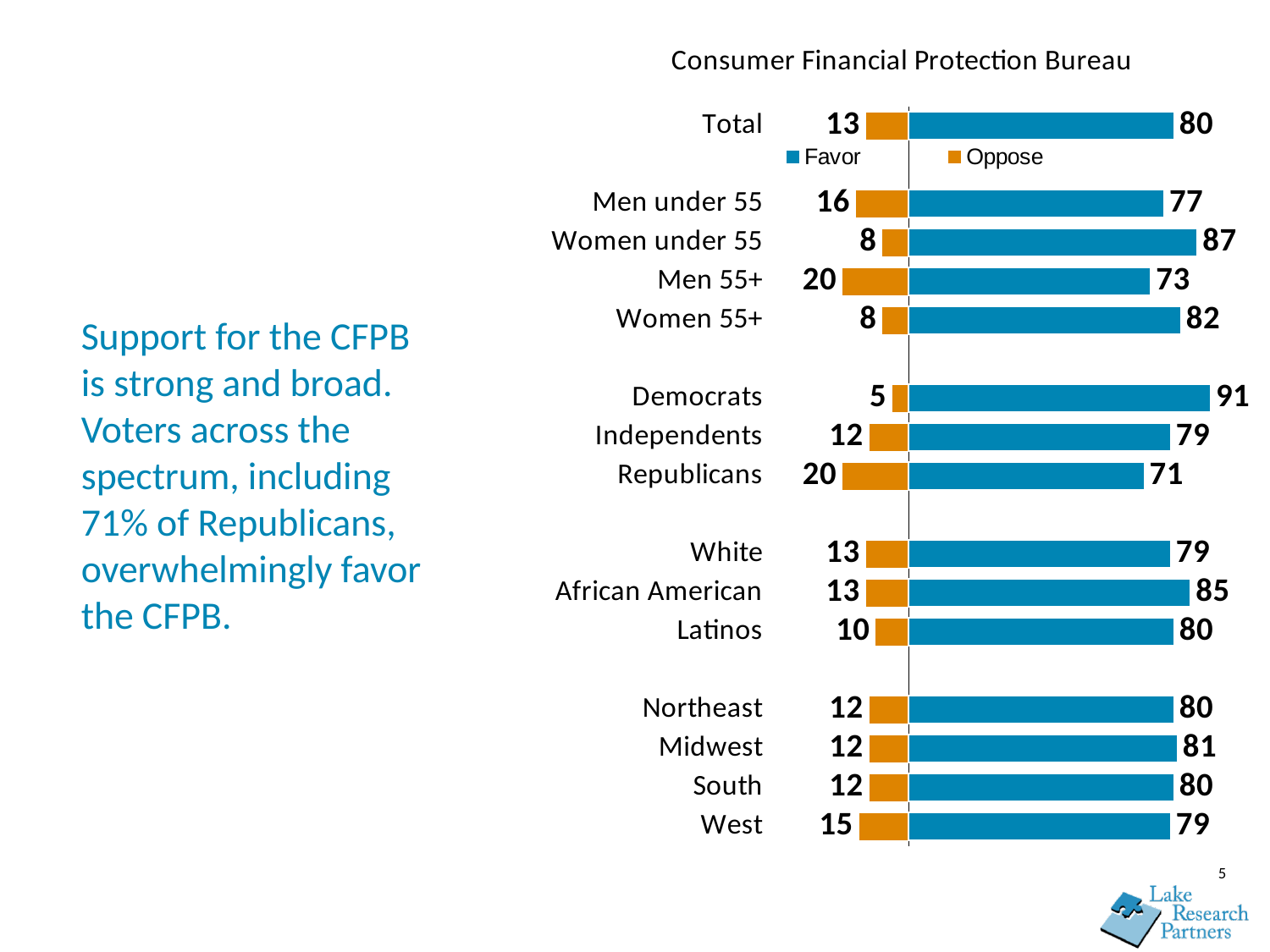
What kind of chart is shown on the slide? Bar chart What is the Oppose value for Men 55+? 20 How many series does the legend list? 2 Which category has the highest Favor value? Democrats How many categories are shown on the chart? 16 Which category has the lowest Oppose value? Democrats Which has a higher Favor value, African American or White? African American What is the Favor value for Women under 55? 87 What is the Favor value for Republicans? 71 What is the difference between the Favor values for Democrats and Republicans? 20 Which colour represents the Oppose series? Orange What is the title of the chart? Consumer Financial Protection Bureau